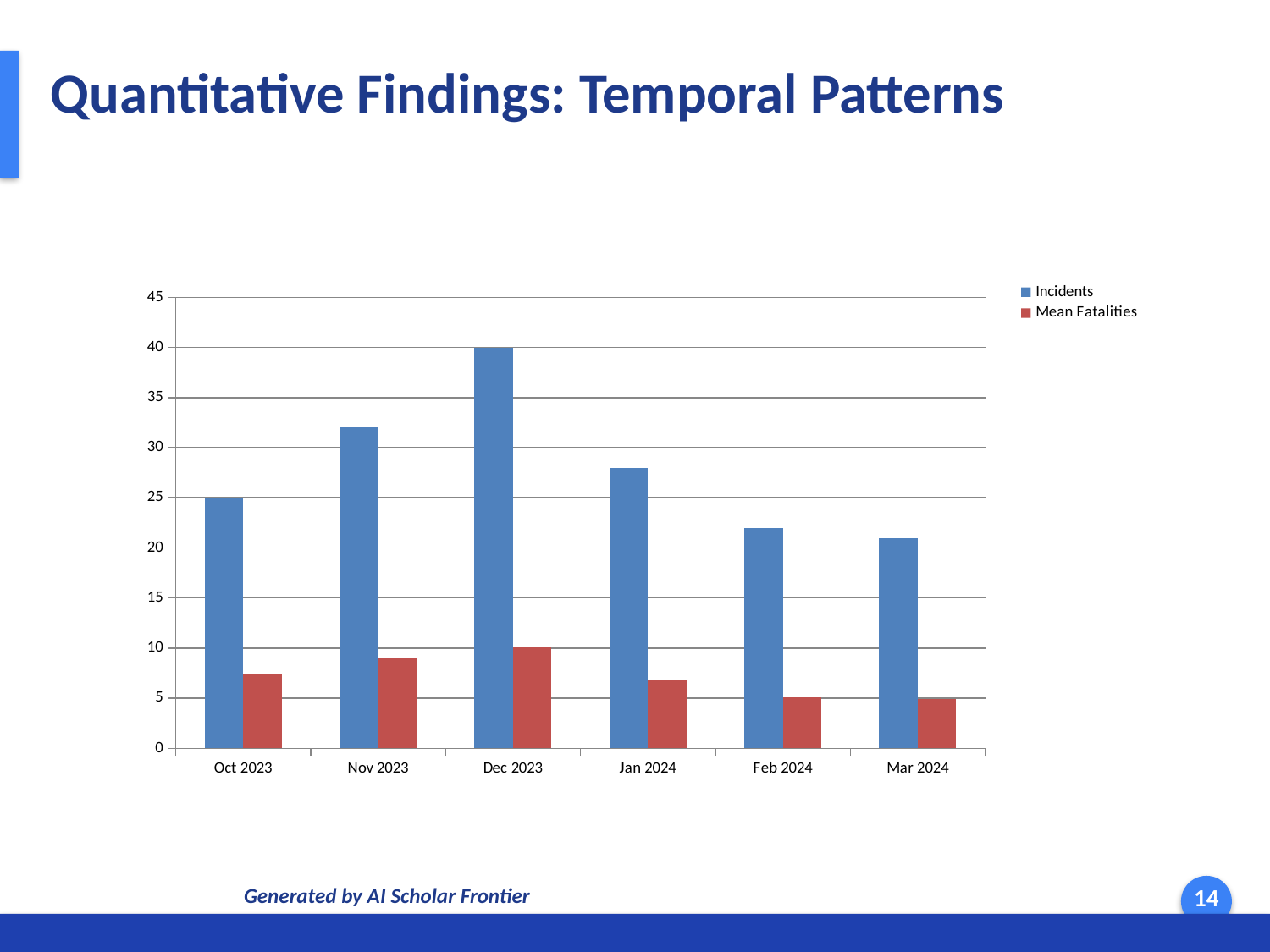
How many series does the legend list? 2 Do Incidents rise or fall from Dec 2023 to Mar 2024? fall What is the Incidents value for Dec 2023? 40 How many months are shown on the x axis? 6 What is the difference in Incidents between Dec 2023 and Oct 2023? 15 Which month has more Incidents, Nov 2023 or Jan 2024? Nov 2023 What type of chart is shown on the slide? bar chart Which month has the highest number of Incidents? Dec 2023 What is the Incidents value for Oct 2023? 25 Is the Incidents value for Nov 2023 greater or less than 30? greater Which month has the highest Mean Fatalities? Dec 2023